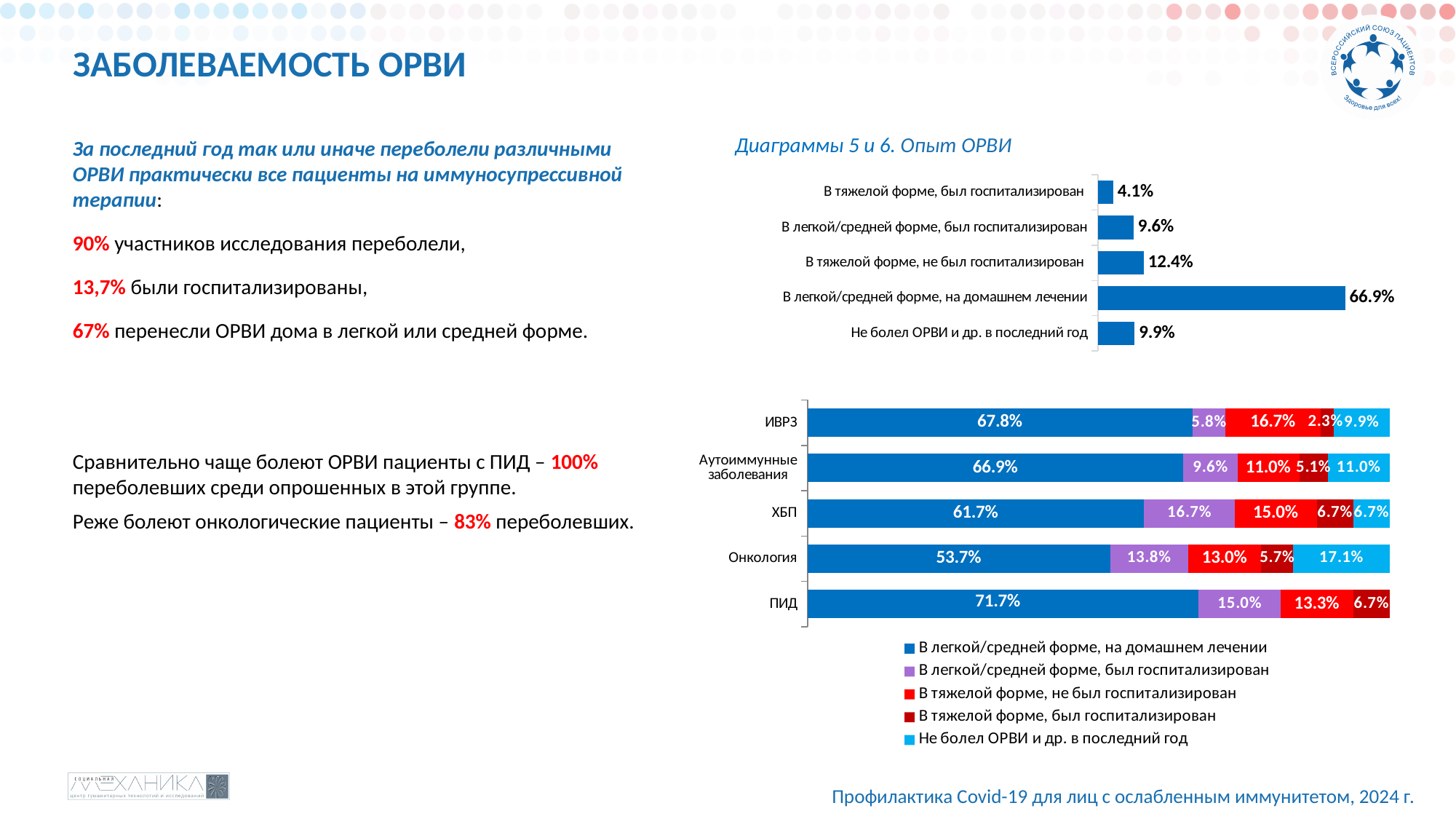
In the bottom stacked bar chart, how many series does the legend list? 5 In the bottom stacked bar chart, what is the difference between the 'В легкой/средней форме, был госпитализирован' values for ХБП and ИВРЗ? 10.9% In the bottom stacked bar chart, which category has the lowest value for 'В легкой/средней форме, на домашнем лечении'? Онкология In the top bar chart, how many categories are shown? 5 What kind of chart is the bottom chart? Stacked bar chart In the top bar chart, which category has the lowest value? В тяжелой форме, был госпитализирован In the top bar chart, what is the value for 'В легкой/средней форме, на домашнем лечении'? 66.9% In the top bar chart, what is the difference between 'В тяжелой форме, не был госпитализирован' and 'В легкой/средней форме, был госпитализирован'? 2.8% In the bottom stacked bar chart, what is the value for 'Не болел ОРВИ и др. в последний год' for Онкология? 17.1% In the bottom stacked bar chart, what is the value for 'В легкой/средней форме, на домашнем лечении' for ПИД? 71.7% In the bottom stacked bar chart, which category has the highest value for 'В легкой/средней форме, на домашнем лечении'? ПИД In the top bar chart, which is larger: 'Не болел ОРВИ и др. в последний год' or 'В легкой/средней форме, был госпитализирован'? Не болел ОРВИ и др. в последний год